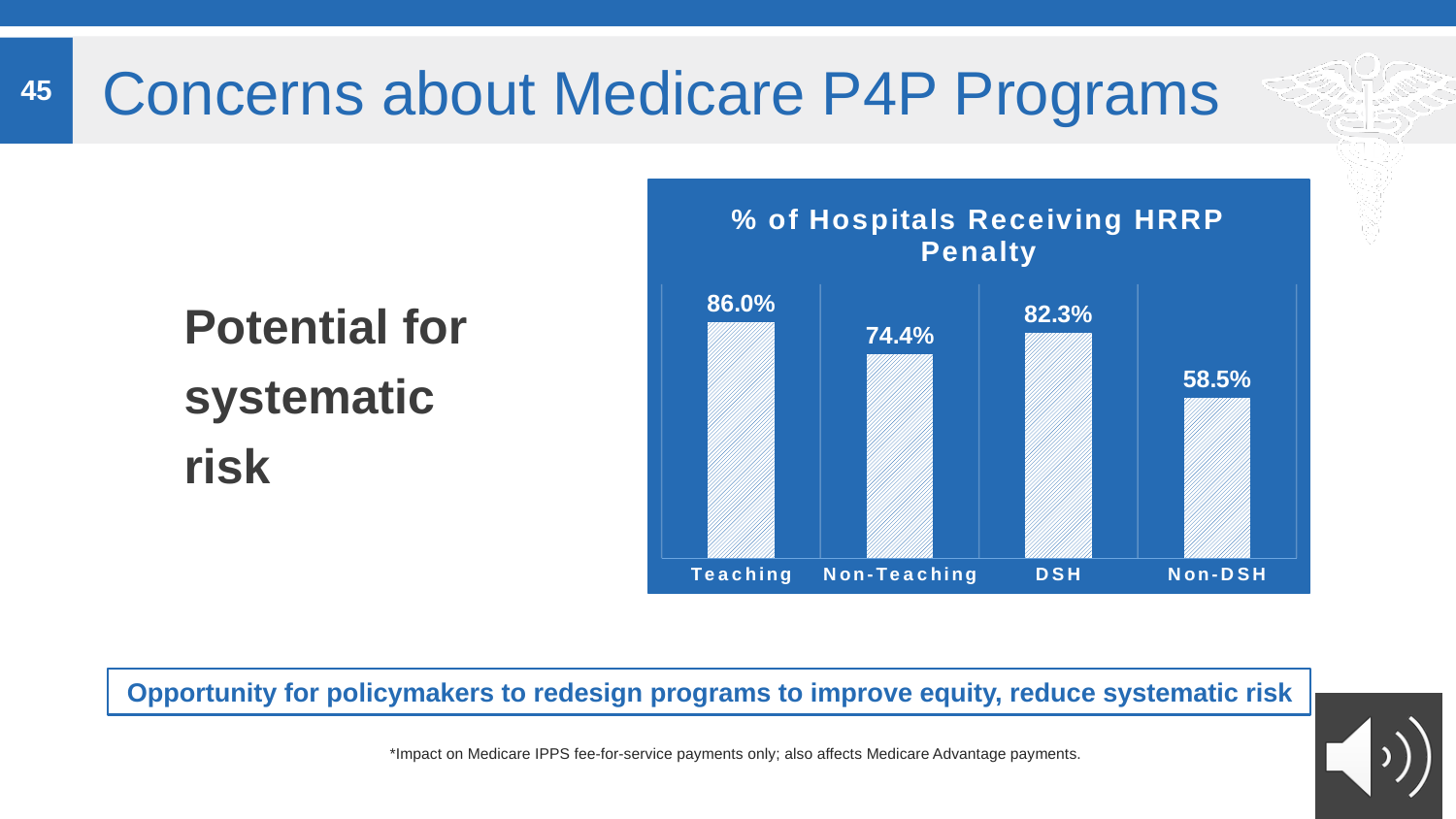
What percentage of Non-DSH hospitals received an HRRP penalty? 58.5% Which hospital category has the lowest percentage receiving an HRRP penalty? Non-DSH What percentage of DSH hospitals received an HRRP penalty? 82.3% What percentage of Teaching hospitals received an HRRP penalty? 86.0% What is the difference in percentage points between Teaching and Non-Teaching hospitals receiving an HRRP penalty? 11.6 How many hospital categories are shown in the chart? 4 What is the title of the chart? % of Hospitals Receiving HRRP Penalty What is the difference in percentage points between DSH and Non-DSH hospitals receiving an HRRP penalty? 23.8 What percentage of Non-Teaching hospitals received an HRRP penalty? 74.4% Which hospital category has the highest percentage receiving an HRRP penalty? Teaching What type of chart is shown on the slide? Bar chart Which has a higher percentage of hospitals receiving an HRRP penalty, DSH or Non-Teaching? DSH